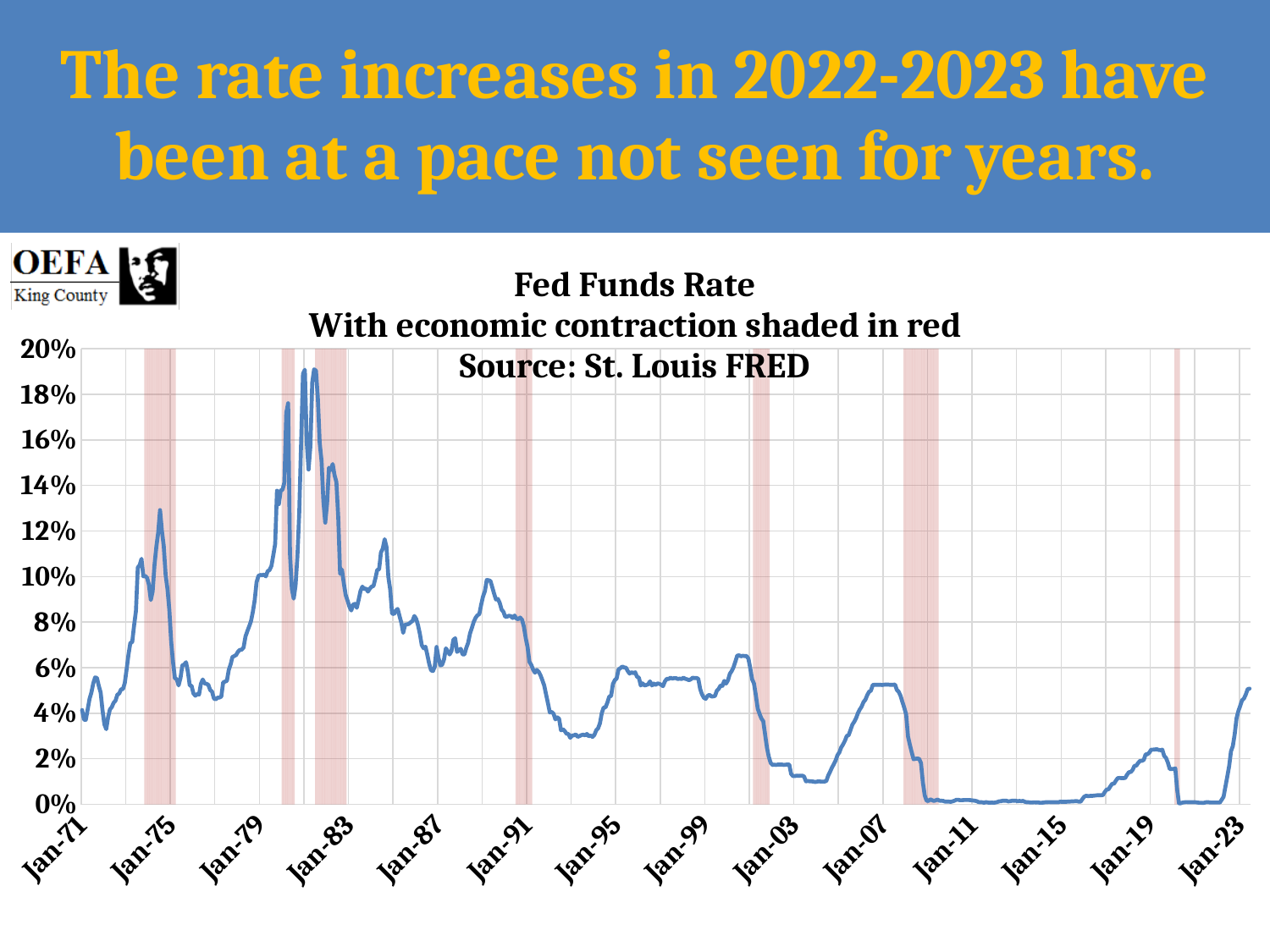
Is the Fed Funds Rate at Jan-03 greater or less than 2%? less What is the title of the chart? Fed Funds Rate Between which two x-axis labels does the Fed Funds Rate reach its highest value? Jan-79 and Jan-83 What kind of chart is shown on the slide? Line chart According to the chart subtitle, what do the red shaded areas represent? Economic contraction Is the Fed Funds Rate at Jan-11 greater or less than 2%? less Is the Fed Funds Rate at Jan-91 greater or less than 6%? greater How many date labels are shown on the x axis? 14 Does the Fed Funds Rate rise or fall between Jan-07 and Jan-11? Fall How many data series are plotted on the chart? 1